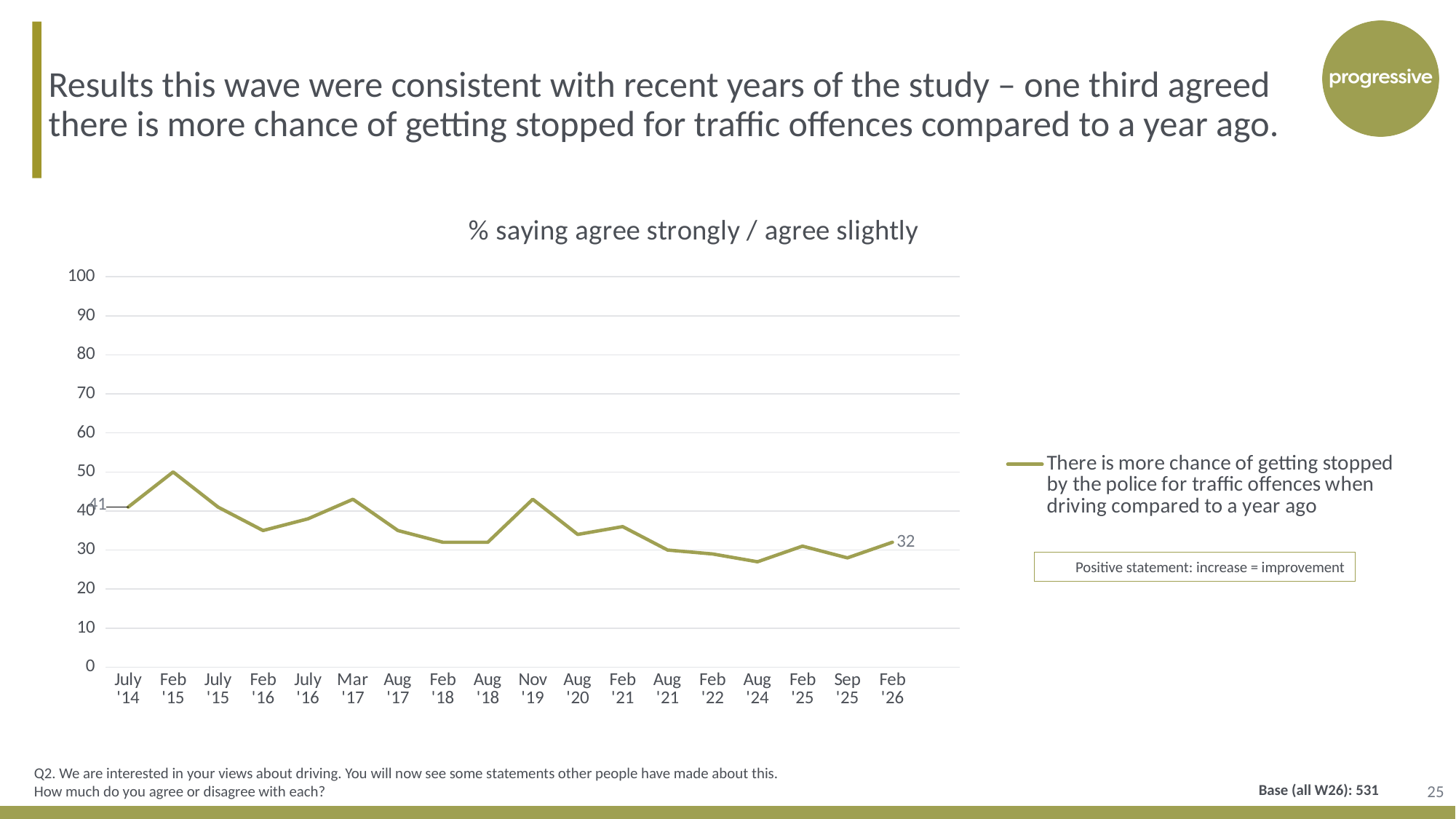
Which time point has the highest value? Feb '15 What is the value for Feb '26? 32 Which is larger, the value for July '14 or the value for Feb '26? July '14 Is the value for Feb '15 greater or less than 40? greater What is the difference between the July '14 value and the Feb '26 value? 9 Is the value for Nov '19 greater or less than 40? greater What is the value for July '14? 41 Is the value for Aug '24 greater or less than 30? less How many time points are plotted on the x axis? 18 How many series does the legend list? 1 What kind of chart is shown? line chart What is the title of the chart? % saying agree strongly / agree slightly